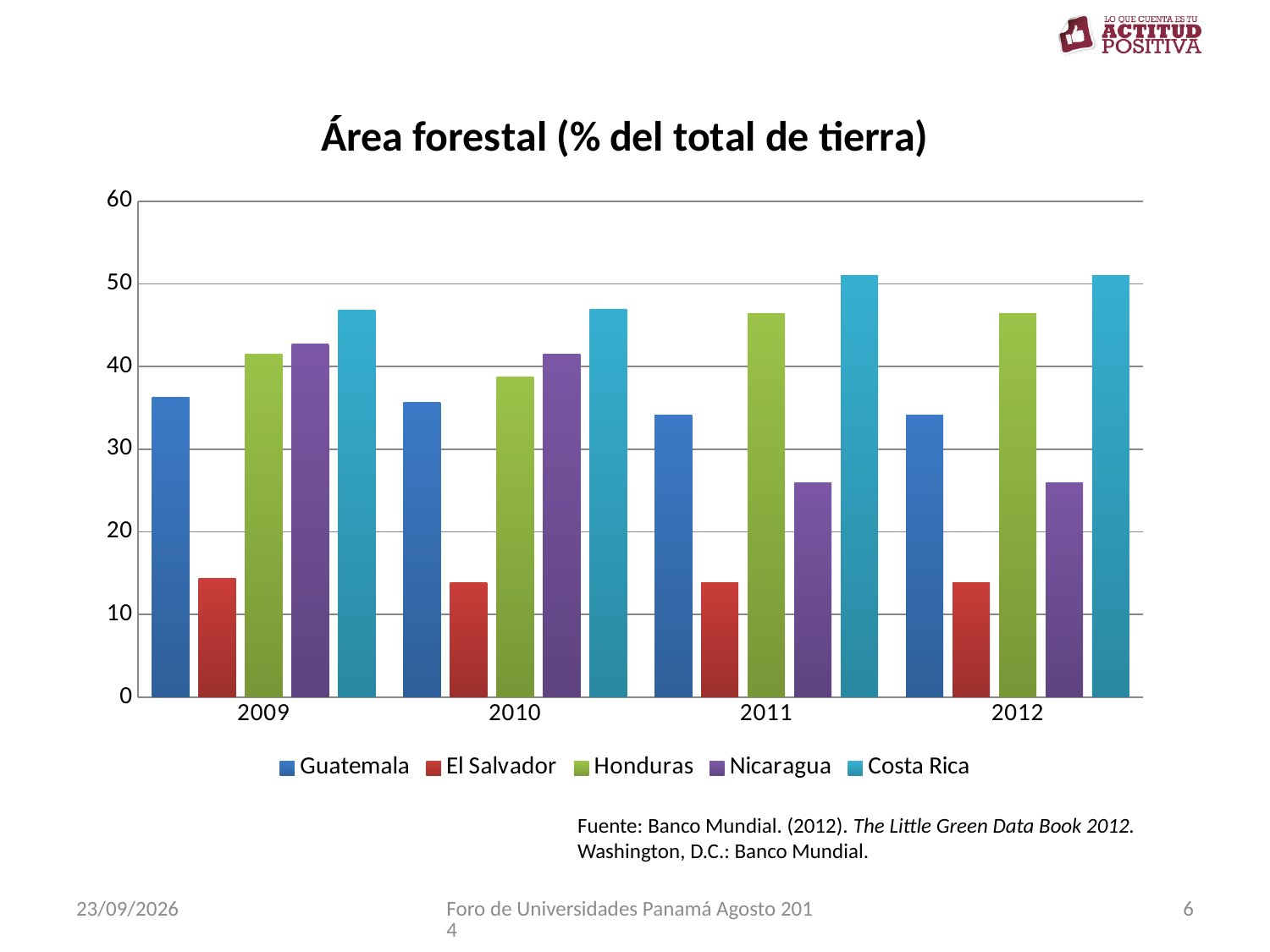
How many years are shown on the x axis? 4 What kind of chart is shown on the slide? bar chart Which country has the lowest forest area value in 2009? El Salvador Is the value for Honduras in 2011 greater or less than 40? greater Does the value for Nicaragua rise or fall from 2009 to 2012? fall Is the value for Costa Rica in 2011 greater or less than 50? greater In 2011, which is larger: the value for Guatemala or the value for Nicaragua? Guatemala How many series does the legend list? 5 What is the title of the chart? Área forestal (% del total de tierra) Which country has the highest forest area value in 2011? Costa Rica Is the value for Nicaragua in 2012 greater or less than 30? less